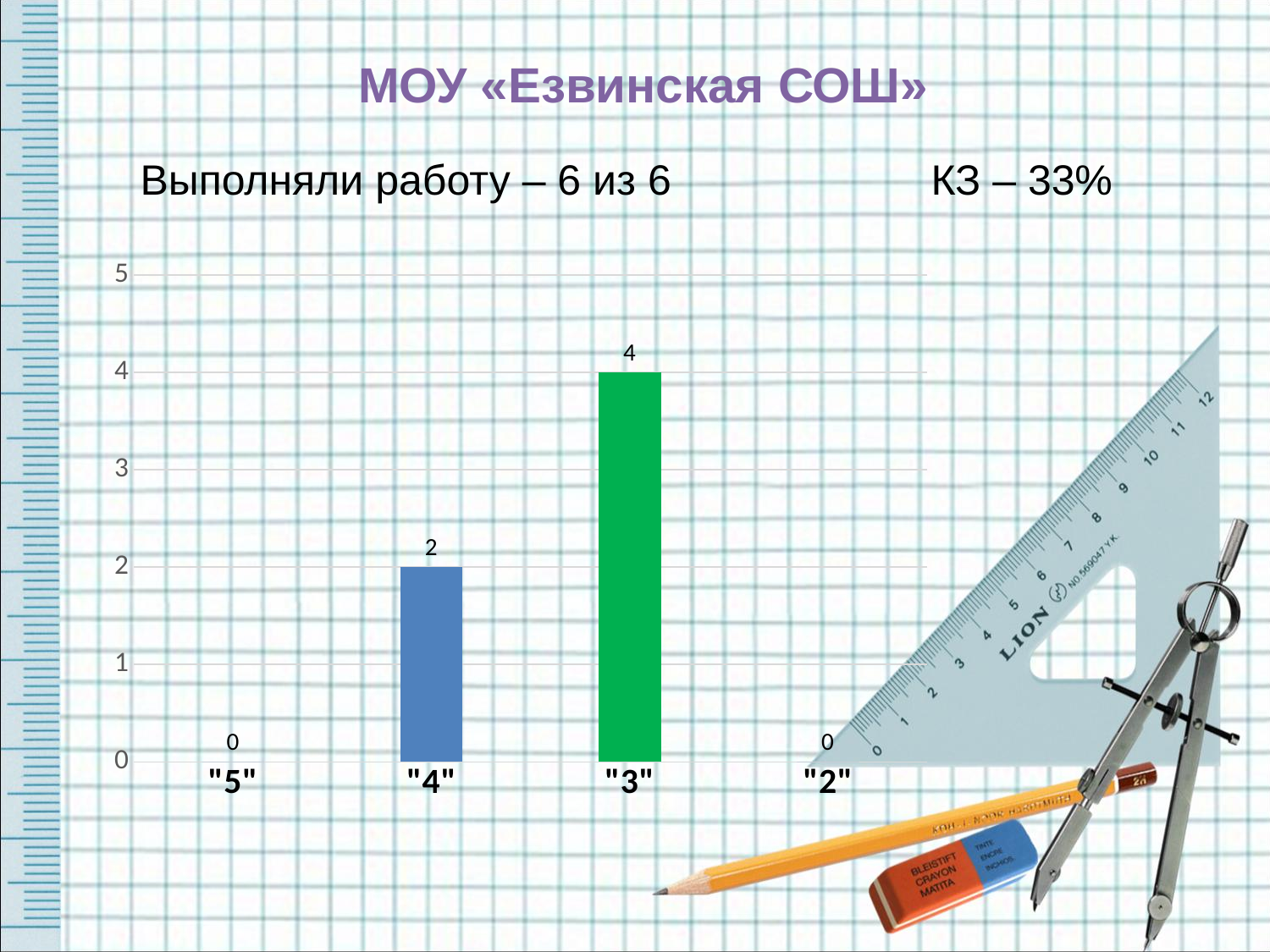
What kind of chart is shown on the slide? bar chart What is the value for the "5" category? 0 Which category has the highest value? "3" What is the value for the "4" category? 2 Is the value for "3" greater or less than 3? greater What is the difference between the values for "3" and "4"? 2 What is the total of all the bar values in the chart? 6 What colour is the bar for the "3" category? green Which is larger, the value for "4" or the value for "3"? "3" What is the value for the "3" category? 4 How many categories are shown on the x axis? 4 What is the value for the "2" category? 0